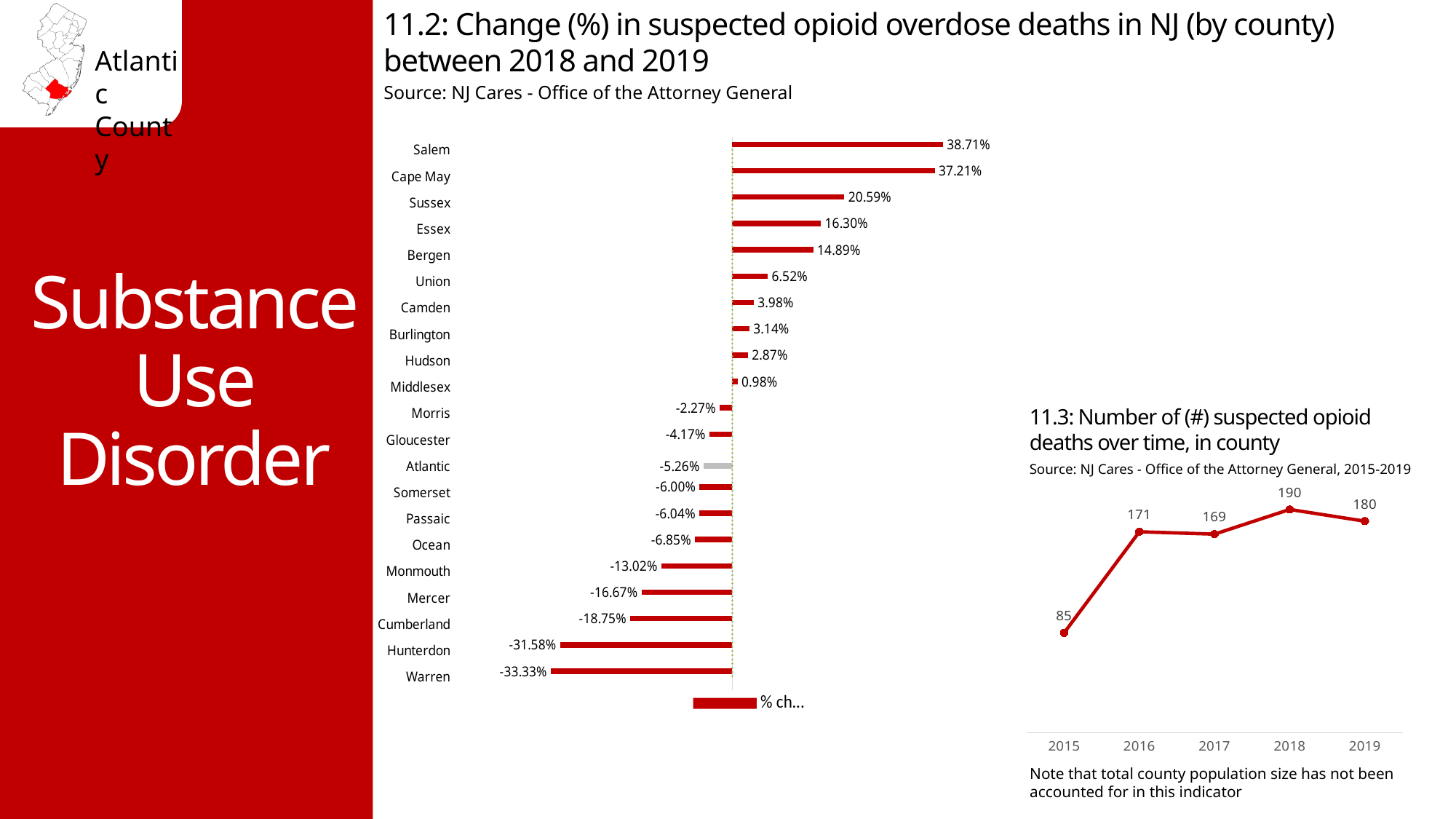
In the chart '11.2: Change (%) in suspected opioid overdose deaths in NJ (by county) between 2018 and 2019', which is larger, the value for Sussex or the value for Essex? Sussex In the chart '11.3: Number of (#) suspected opioid deaths over time, in county', which year has the lowest value? 2015 In the chart '11.2: Change (%) in suspected opioid overdose deaths in NJ (by county) between 2018 and 2019', what is the value for Atlantic? -5.26% In the chart '11.3: Number of (#) suspected opioid deaths over time, in county', what is the value for 2018? 190 In the chart '11.2: Change (%) in suspected opioid overdose deaths in NJ (by county) between 2018 and 2019', what is the value for Salem? 38.71% In the chart '11.2: Change (%) in suspected opioid overdose deaths in NJ (by county) between 2018 and 2019', which county has the lowest value? Warren What kind of chart is '11.2: Change (%) in suspected opioid overdose deaths in NJ (by county) between 2018 and 2019'? Bar chart In the chart '11.2: Change (%) in suspected opioid overdose deaths in NJ (by county) between 2018 and 2019', how many counties are shown? 21 In the chart '11.2: Change (%) in suspected opioid overdose deaths in NJ (by county) between 2018 and 2019', what is the difference between the values for Salem and Cape May? 1.50% In the chart '11.2: Change (%) in suspected opioid overdose deaths in NJ (by county) between 2018 and 2019', which county has the highest value? Salem In the chart '11.3: Number of (#) suspected opioid deaths over time, in county', what is the difference between the values for 2016 and 2015? 86 What kind of chart is '11.3: Number of (#) suspected opioid deaths over time, in county'? Line chart